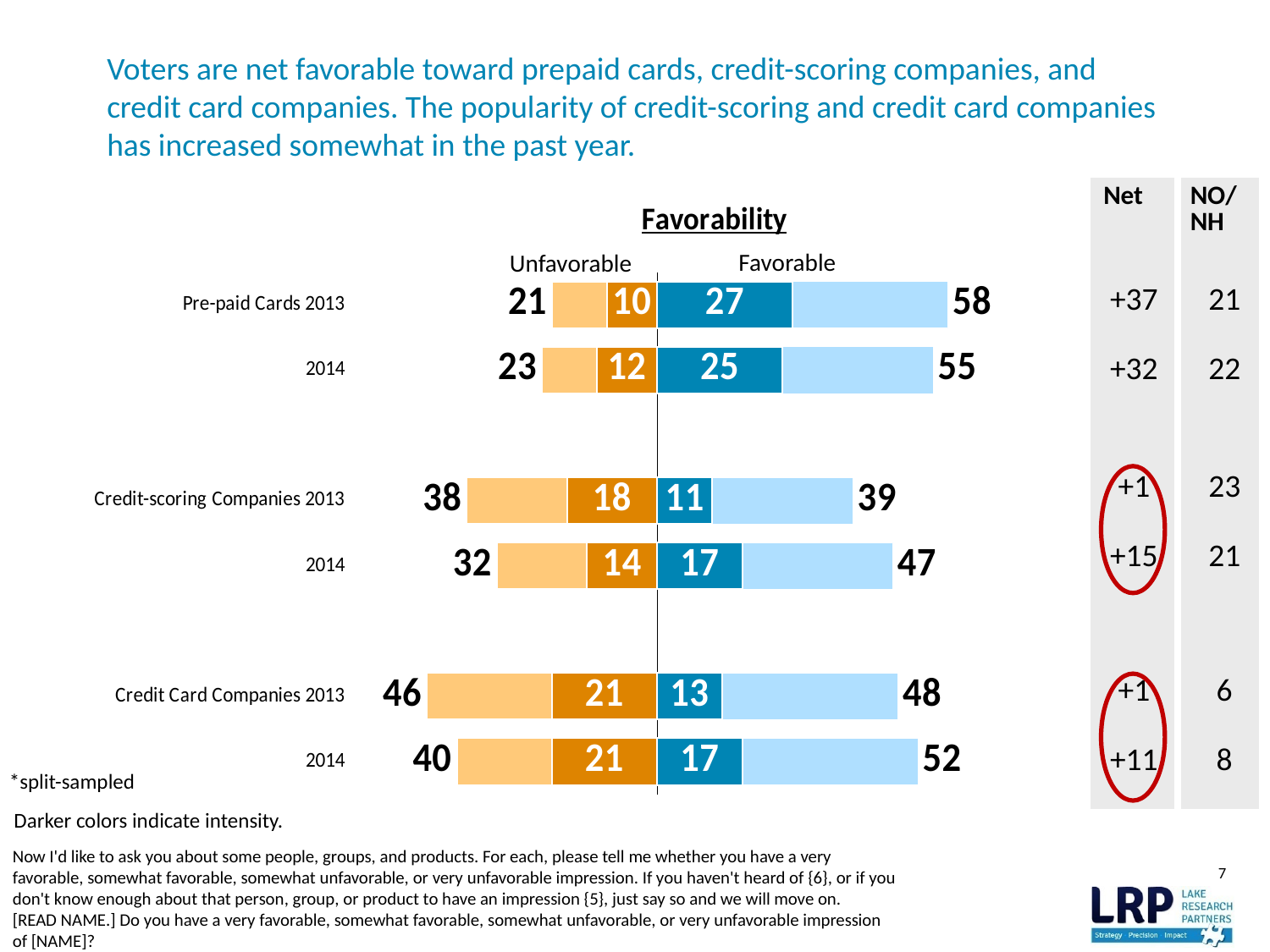
What is the very unfavorable (darker orange) value for Pre-paid Cards in 2014? 12 What is the total favorable value for Pre-paid Cards in 2013? 58 What kind of chart is shown on the slide? Bar chart What is the total unfavorable value for Credit Card Companies in 2013? 46 What is the very favorable (darker blue) value for Credit-scoring Companies in 2014? 17 Which bar has the lowest total favorable value? Credit-scoring Companies 2013 Which is larger: the total favorable value for Credit Card Companies in 2014 or for Credit-scoring Companies in 2014? Credit Card Companies 2014 What is the title of the chart? Favorability What is the difference between the total unfavorable values for Credit Card Companies in 2013 and 2014? 6 Which bar has the highest total favorable value? Pre-paid Cards 2013 How many bars are plotted in the chart? 6 By how much did the total favorable value for Credit-scoring Companies increase from 2013 to 2014? 8